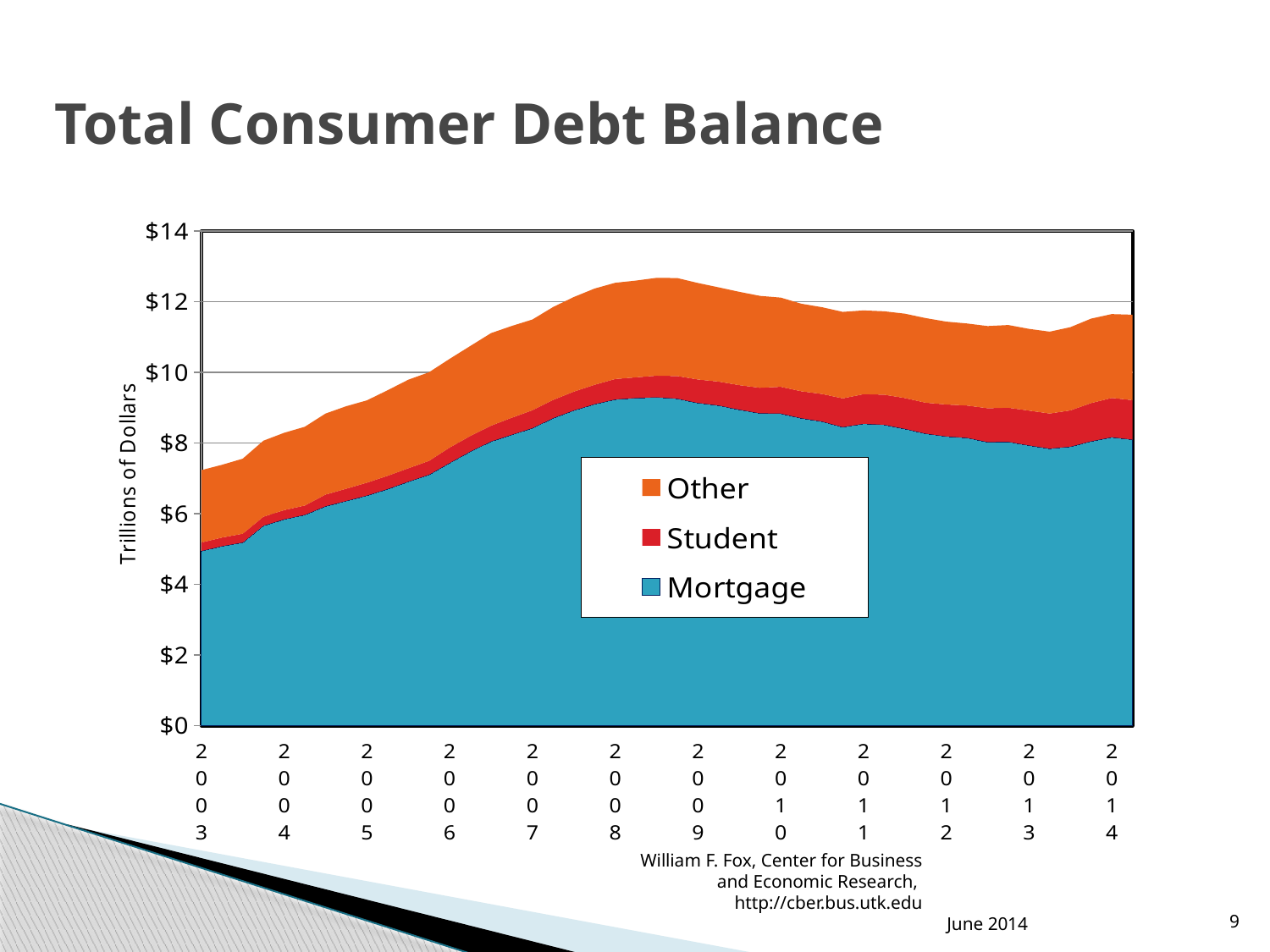
Is the total consumer debt balance in 2003 greater or less than $6? greater Does the total consumer debt balance rise or fall from 2003 to 2008? rise Is the total consumer debt balance at its 2008-2009 peak greater or less than $12? greater What is the label on the vertical axis? Trillions of Dollars Is the Mortgage balance in 2003 greater or less than $6? less How many years are labelled along the x axis? 12 How many series does the legend list? 3 Does the Mortgage balance rise or fall from 2009 to 2013? fall Which series is plotted at the bottom of the stack? Mortgage What kind of chart is shown on the slide? Stacked area chart